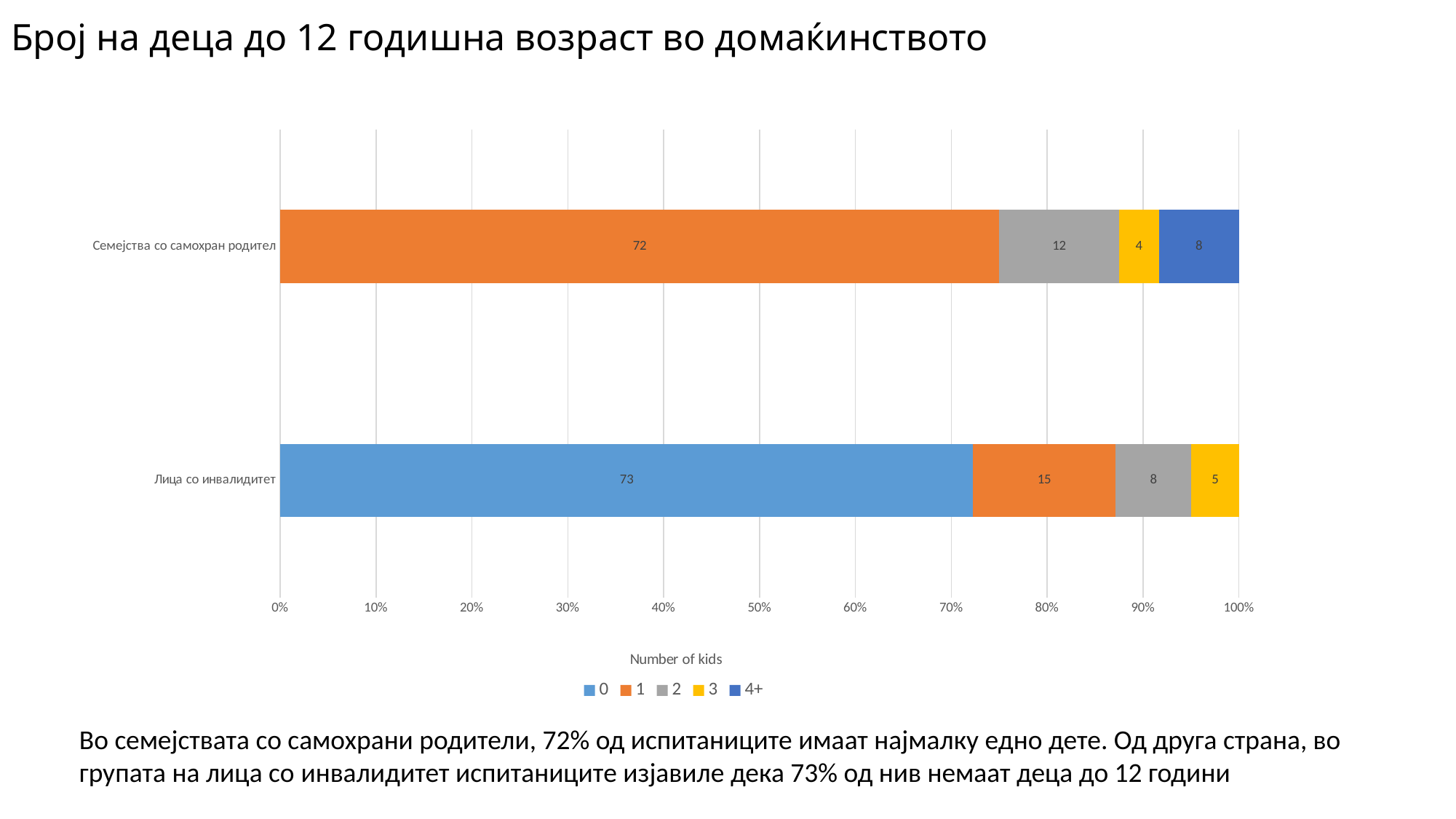
What is the difference between the value of series "1" for "Лица со инвалидитет" and the value of series "2" for "Лица со инвалидитет"? 7 Which series has the smallest segment in the "Семејства со самохран родител" bar? 3 What is the title of the legend (axis title) shown below the chart? Number of kids What is the value of series "1" for "Семејства со самохран родител"? 72 Which series has the largest segment in the "Лица со инвалидитет" bar? 0 What is the value of series "3" for "Лица со инвалидитет"? 5 What kind of chart is shown on the slide? stacked bar chart What is the value of series "0" for "Лица со инвалидитет"? 73 How many categories (bars) are shown in the chart? 2 How many series does the legend list? 5 What is the value of series "4+" for "Семејства со самохран родител"? 8 Which is larger: the value of series "2" for "Семејства со самохран родител" or the value of series "2" for "Лица со инвалидитет"? Семејства со самохран родител